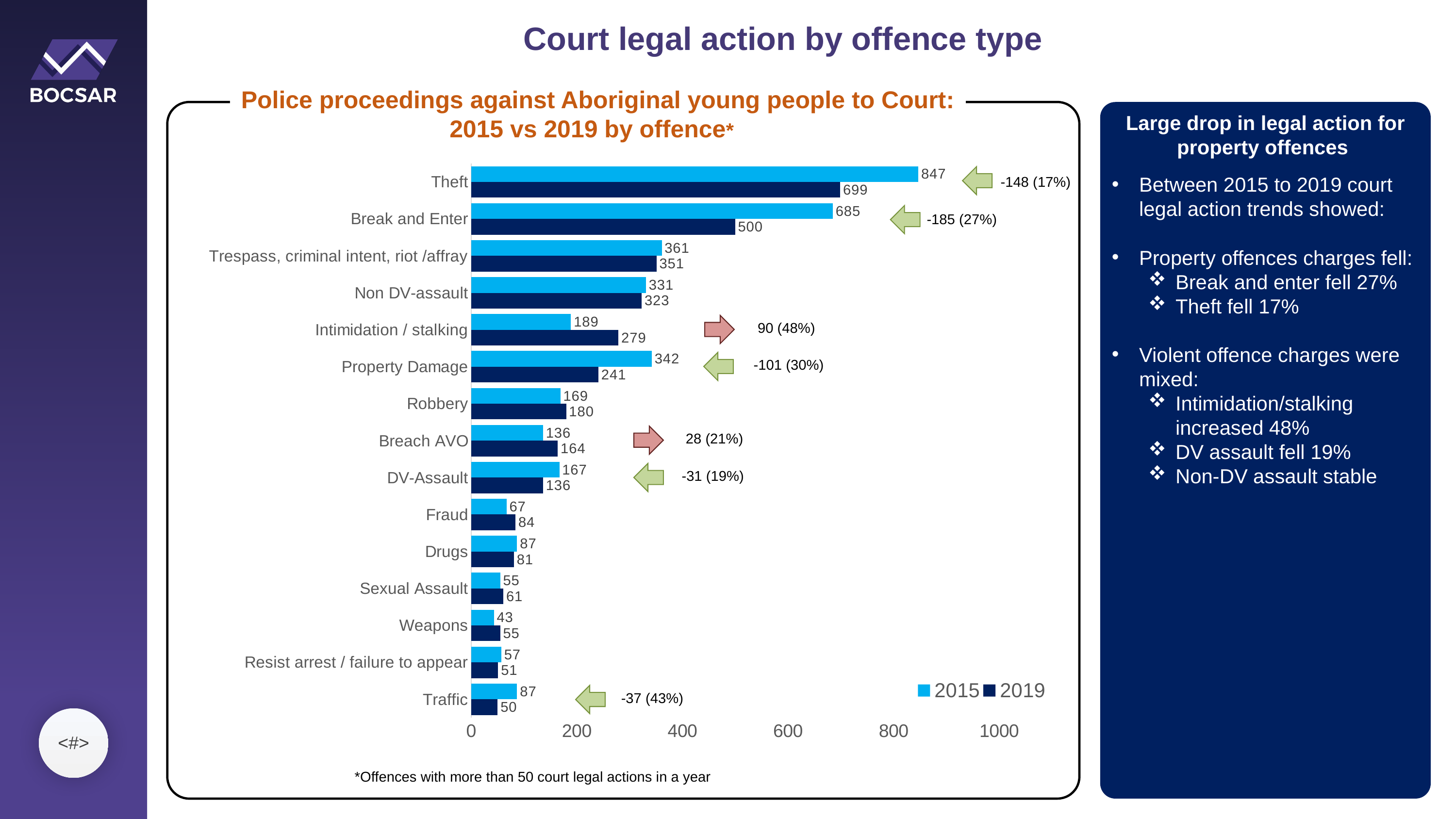
What percentage change is shown next to the Traffic bars? -37 (43%) What is the difference between the 2015 and 2019 values for Property Damage? 101 Is the 2019 value for Trespass, criminal intent, riot /affray greater or less than 200? greater What was the value for Break and Enter in 2019? 500 Which is larger for Breach AVO, the 2015 value or the 2019 value? 2019 Which offence type had the highest value in 2015? Theft What was the value for Theft in 2015? 847 How many offence types are shown on the chart? 15 Which offence type had the lowest value in 2015? Weapons How many series does the legend list? 2 What kind of chart is shown on the slide? Bar chart What was the value for Intimidation / stalking in 2019? 279